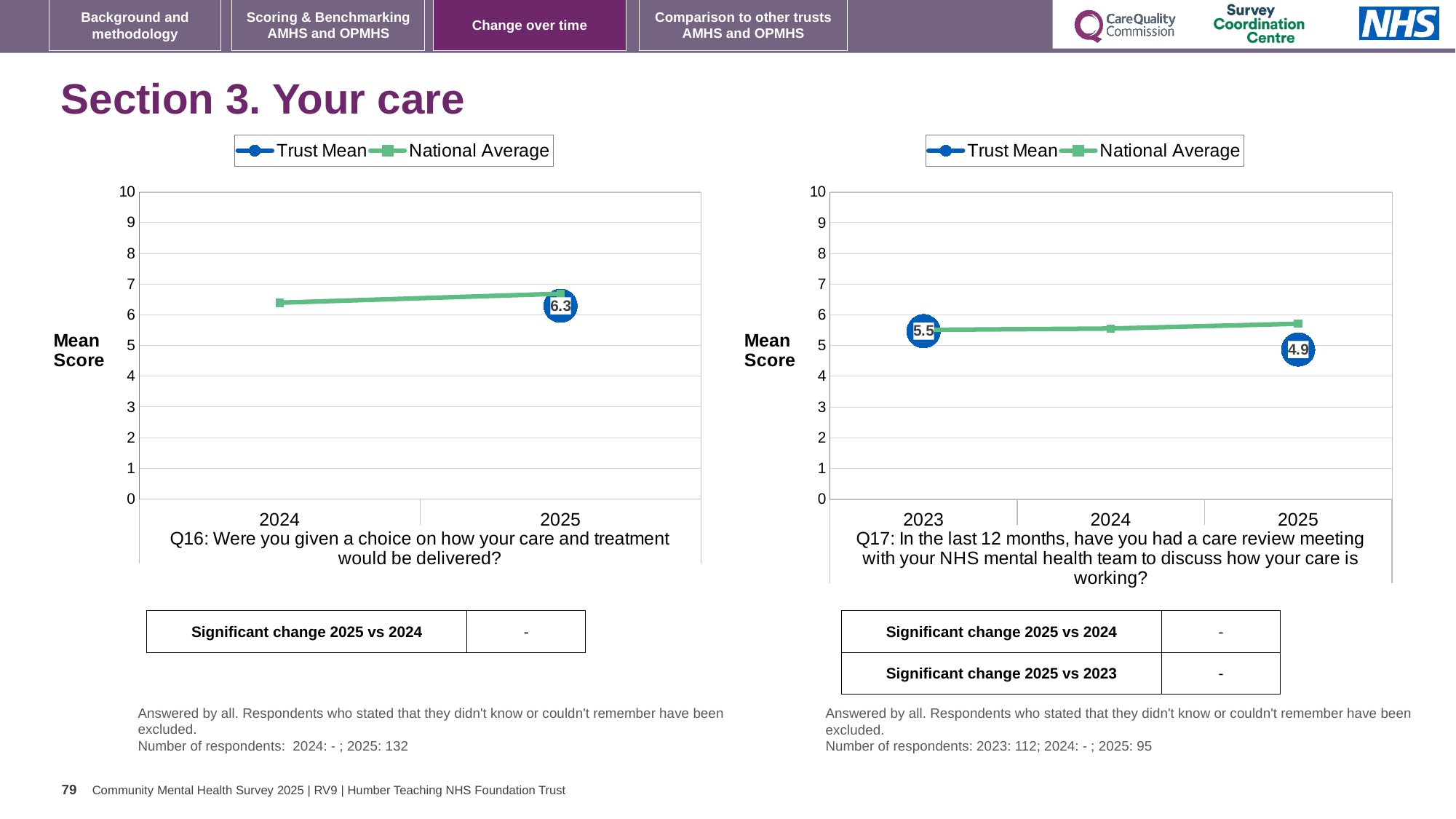
What are the two series named in the legend of the Q17 chart on the right? Trust Mean and National Average In the Q17 chart on the right, which year has the higher Trust Mean, 2023 or 2025? 2023 How many years are shown on the x axis of the Q17 chart on the right? 3 In the Q17 chart on the right, what is the Trust Mean for 2025? 4.9 In the Q17 chart on the right, is the National Average for 2025 greater or less than 5? greater What kind of chart is the Q16 chart on the left? line chart In the Q17 chart on the right, what is the difference between the Trust Mean for 2023 and the Trust Mean for 2025? 0.6 In the Q17 chart on the right, does the Trust Mean rise or fall from 2023 to 2025? fall In the Q16 chart on the left, is the National Average for 2025 greater or less than 6? greater In the Q16 chart on the left, what is the Trust Mean for 2025? 6.3 In the Q17 chart on the right, what is the Trust Mean for 2023? 5.5 How many series does the legend of the Q16 chart on the left list? 2